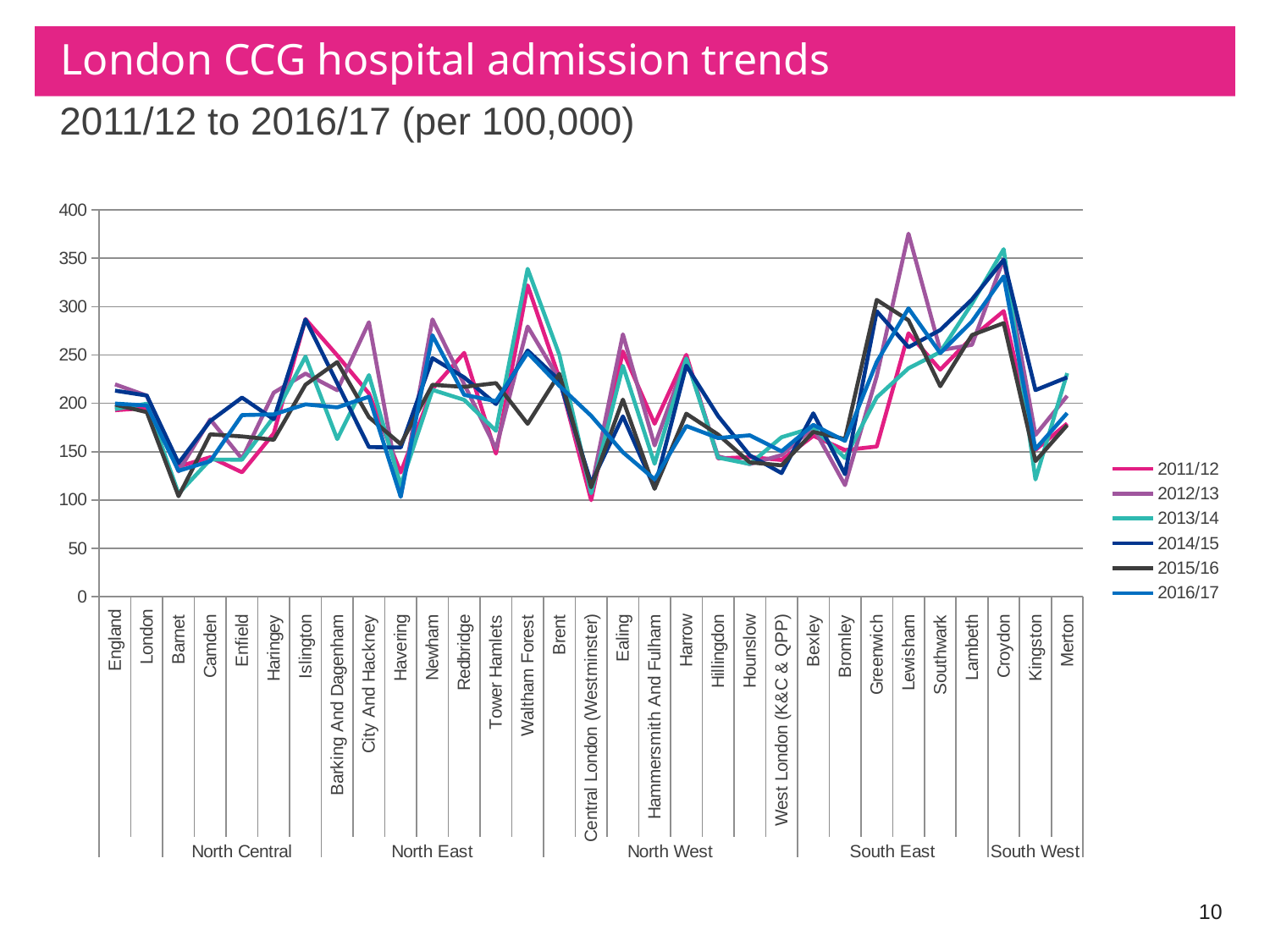
Which category has the highest value for the 2013/14 series? Croydon What kind of chart is shown on the slide? Line chart Is the 2013/14 value for Waltham Forest greater or less than 300? greater Is the 2013/14 value for Kingston greater or less than 150? less Is the 2012/13 value for Lewisham greater or less than 350? greater How many series does the legend list? 6 What is the first series listed in the legend? 2011/12 Which category has the lowest value for the 2011/12 series? Central London (Westminster) How many categories are plotted along the x axis? 31 Which is larger for the 2012/13 series, the value for Lewisham or the value for Southwark? Lewisham Which category has the highest value for the 2012/13 series? Lewisham